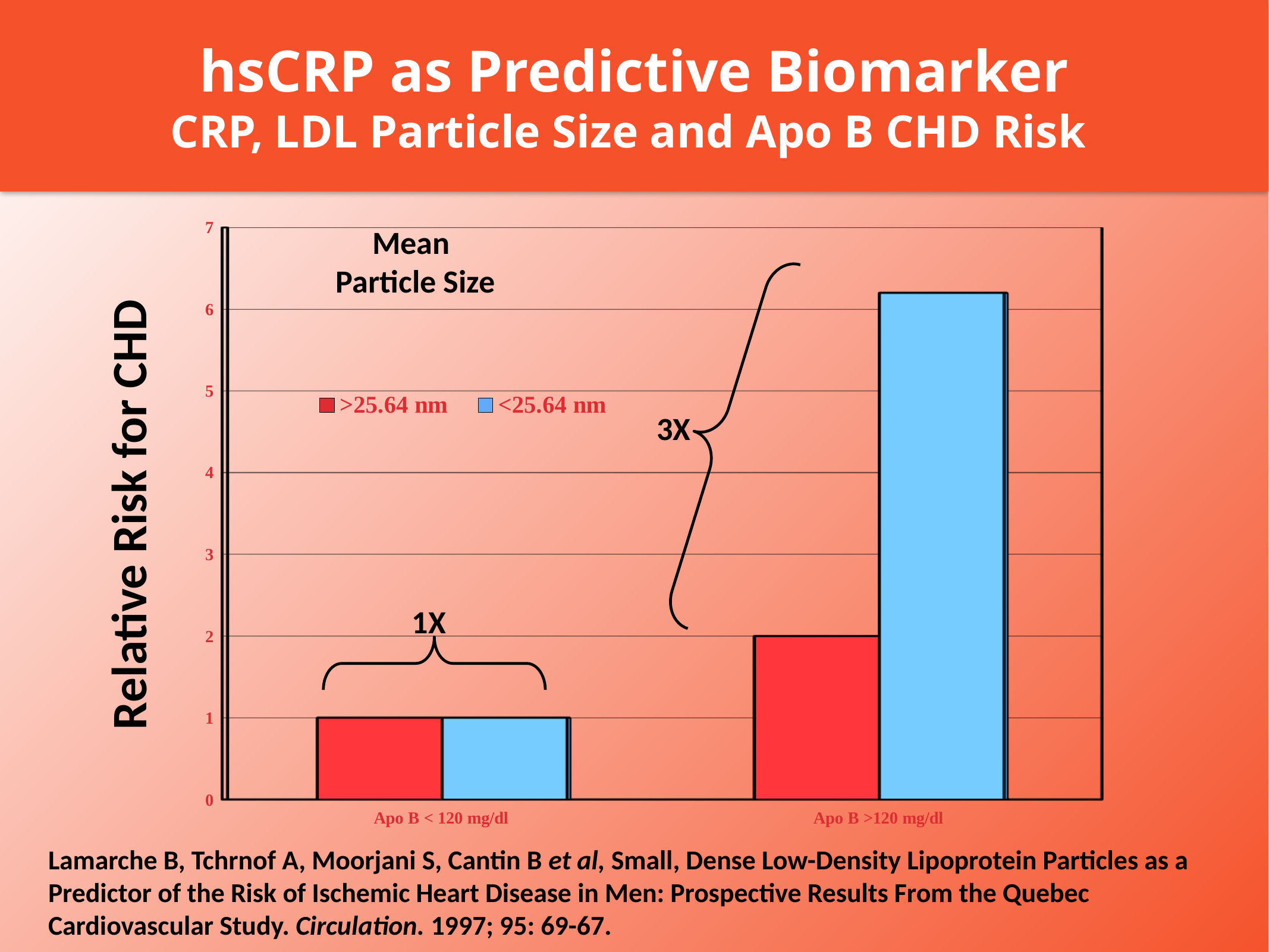
In the Apo B >120 mg/dl category, which series has the larger relative risk, >25.64 nm or <25.64 nm? <25.64 nm What is the relative risk for CHD for the <25.64 nm series in the Apo B < 120 mg/dl category? 1 Which series has the tallest bar in the chart? <25.64 nm Is the value for the <25.64 nm series in the Apo B >120 mg/dl category greater or less than 7? less How many Apo B categories are shown on the x axis? 2 What kind of chart is shown on the slide? bar chart How many series does the chart's legend list? 2 What is the difference in relative risk for the >25.64 nm series between the Apo B >120 mg/dl and Apo B < 120 mg/dl categories? 1 What is the relative risk for CHD for the >25.64 nm series in the Apo B >120 mg/dl category? 2 Is the value for the <25.64 nm series in the Apo B >120 mg/dl category greater or less than 6? greater What is the title of the y axis? Relative Risk for CHD What is the relative risk for CHD for the >25.64 nm series in the Apo B < 120 mg/dl category? 1